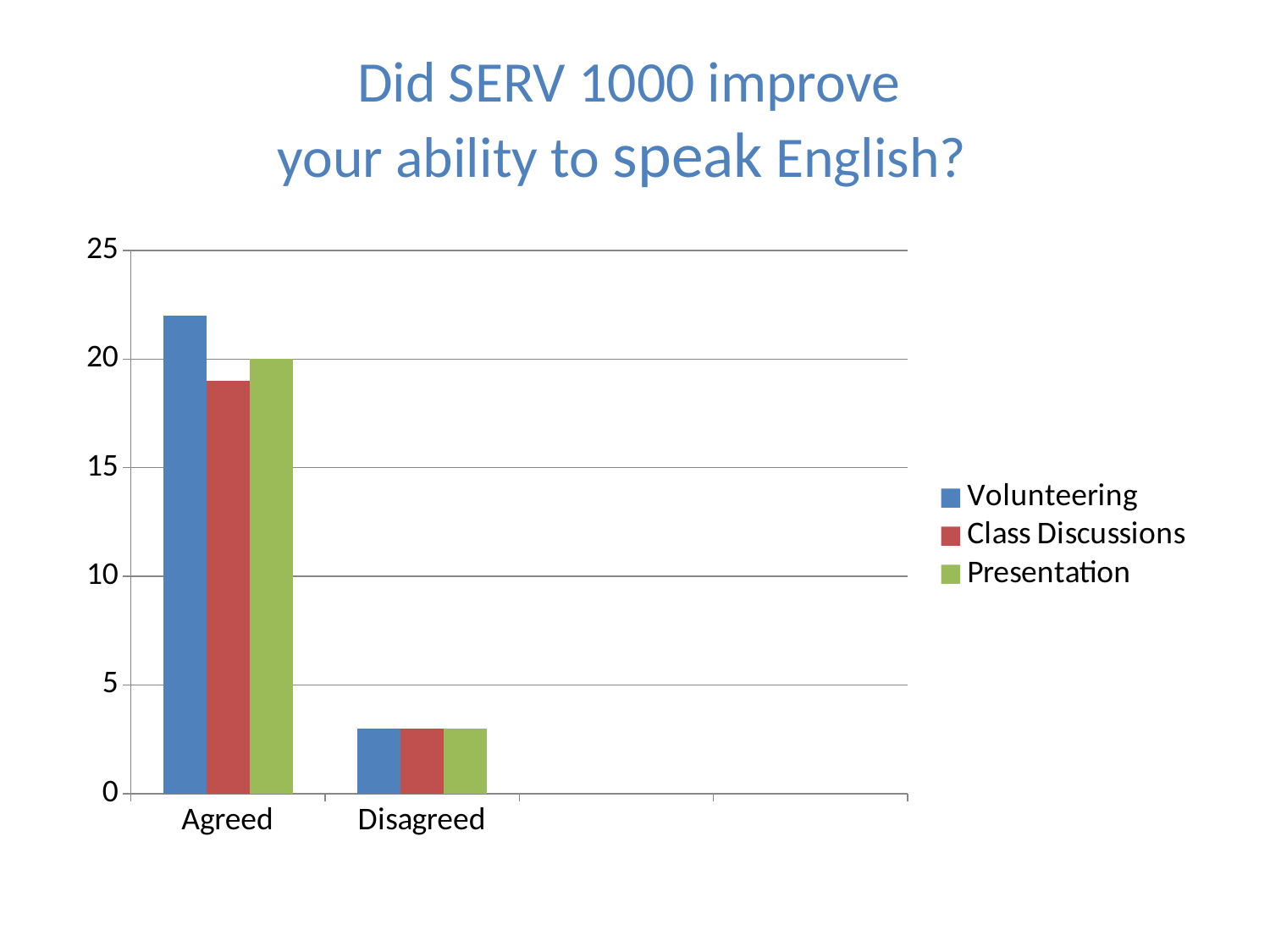
Which series is shown in green? Presentation What kind of chart is shown on the slide? bar chart In the Agreed category, which is larger, Volunteering or Class Discussions? Volunteering What is the value for Presentation in the Agreed category? 20 How many categories are shown on the x axis? 2 Is the value for Class Discussions in the Agreed category greater or less than 20? less How many series does the legend list? 3 Which series has the highest value in the Agreed category? Volunteering For Volunteering, which category has the larger value, Agreed or Disagreed? Agreed Is the value for Volunteering in the Disagreed category greater or less than 5? less Is the value for Volunteering in the Agreed category greater or less than 20? greater What is the title of the chart? Did SERV 1000 improve your ability to speak English?